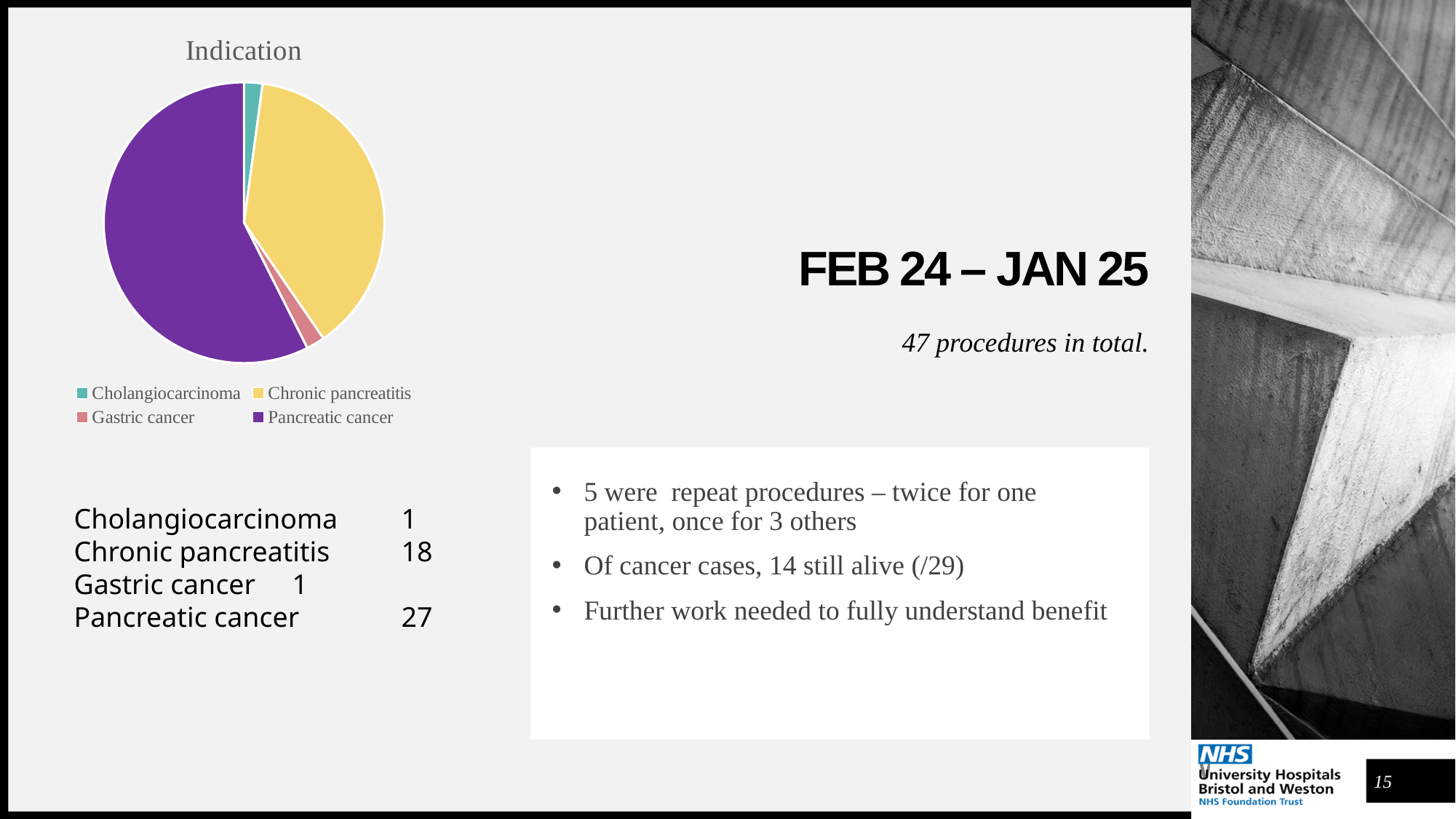
What is the total number of procedures across all indications in the pie chart? 47 How many procedures were for Chronic pancreatitis? 18 How many procedures were for Gastric cancer? 1 What is the title of the pie chart? Indication How many categories does the pie chart show? 4 How many procedures were for Cholangiocarcinoma? 1 Which slice is larger, Pancreatic cancer or Chronic pancreatitis? Pancreatic cancer Which indication has the largest slice of the pie chart? Pancreatic cancer What kind of chart is shown on the slide? pie chart What is the difference between the number of Pancreatic cancer procedures and Chronic pancreatitis procedures? 9 What colour is the Pancreatic cancer slice in the pie chart? purple How many procedures were for Pancreatic cancer? 27